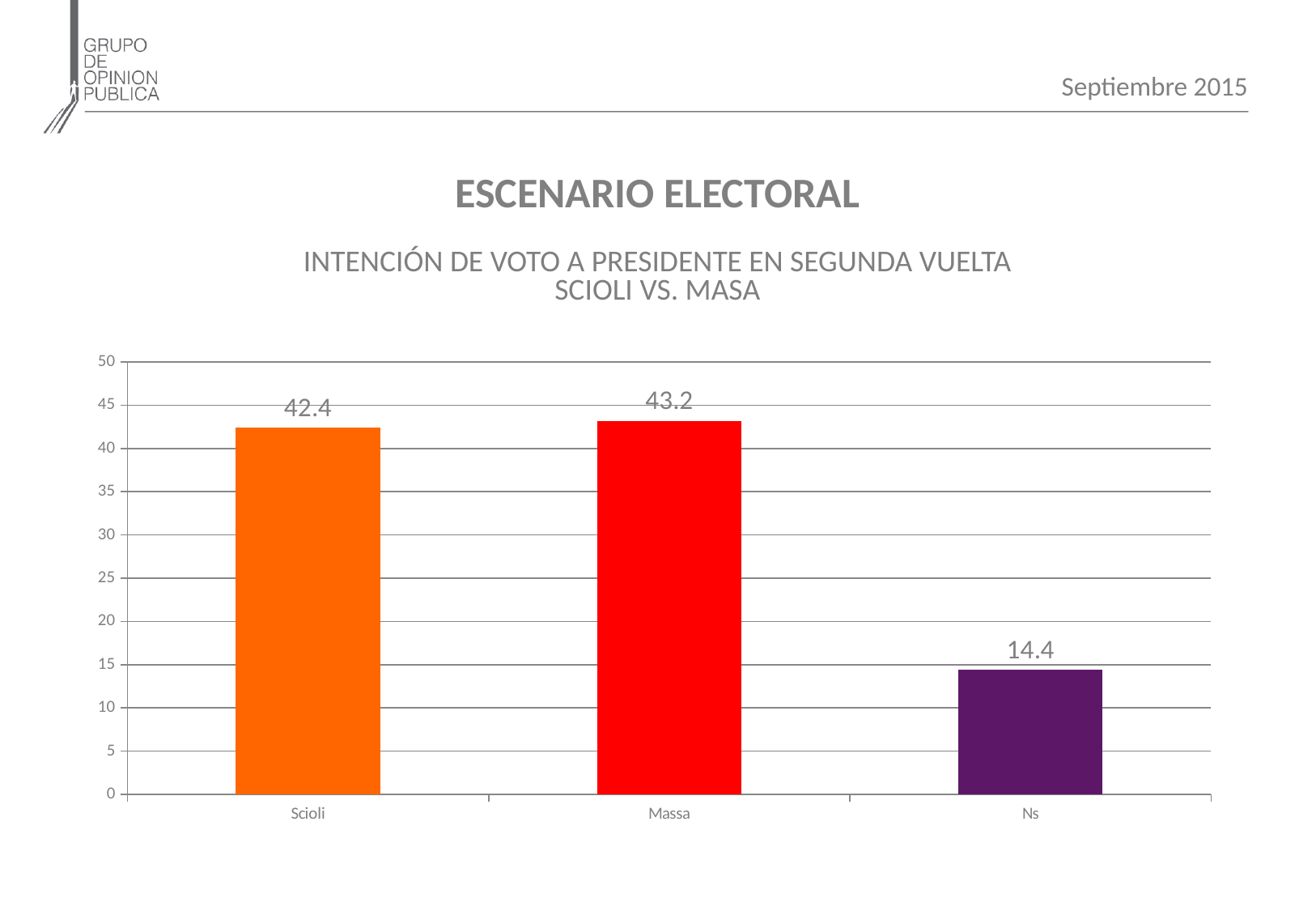
What is the difference between the values for Scioli and Ns? 28 Which category has the lowest value? Ns Which is larger, the value for Scioli or the value for Ns? Scioli What is the value for Scioli? 42.4 How many categories are shown on the x axis? 3 What is the difference between the values for Massa and Scioli? 0.8 What is the value for Ns? 14.4 What kind of chart is shown on the slide? bar chart What is the value for Massa? 43.2 What is the maximum value shown on the y axis? 50 What colour is the bar for Ns? purple Is the value for Ns greater or less than 20? less